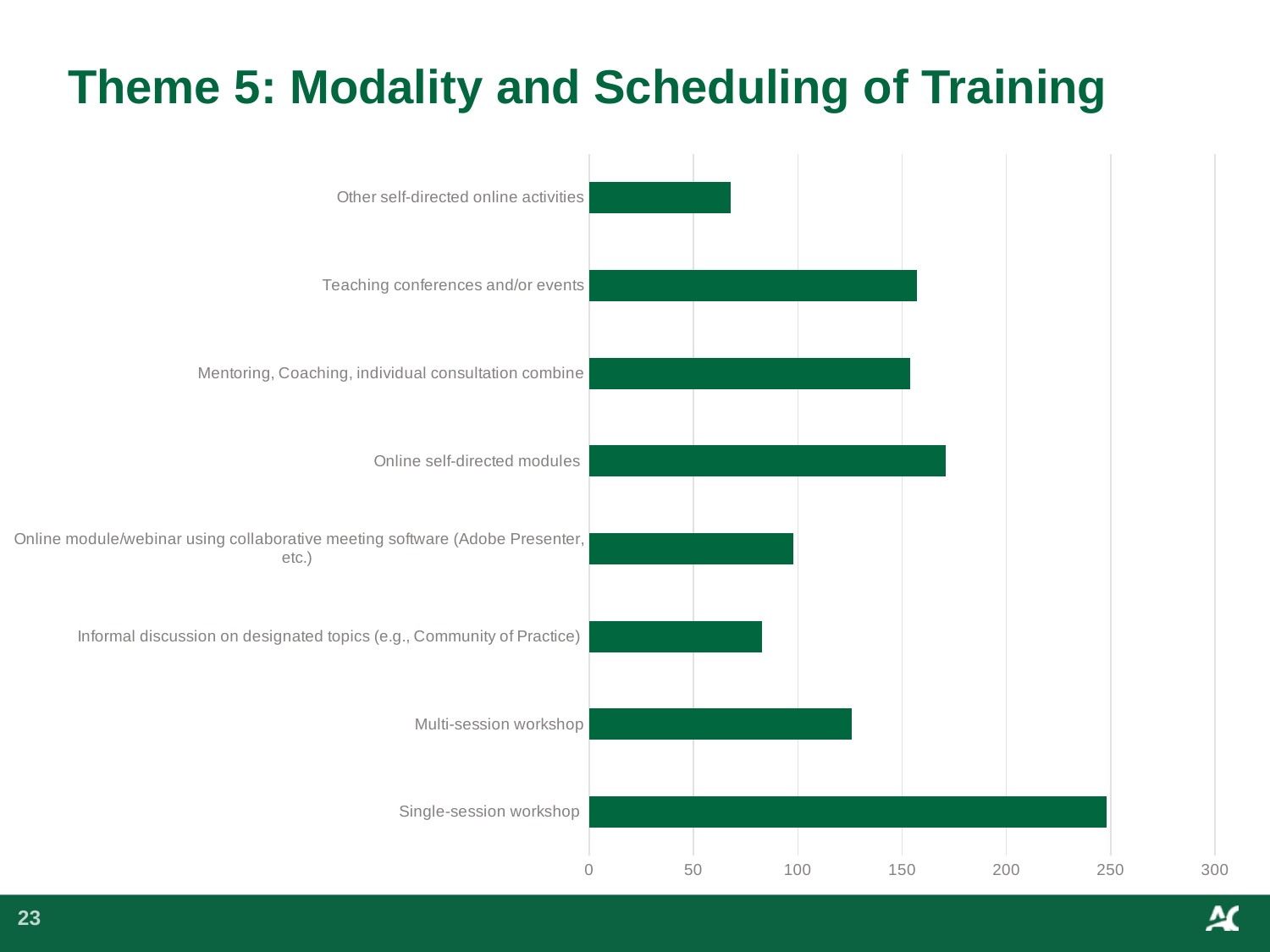
Is the value for Online self-directed modules greater or less than 150? greater Which is larger, the value for Online self-directed modules or the value for Informal discussion on designated topics (e.g., Community of Practice)? Online self-directed modules What kind of chart is shown on the slide? Bar chart Is the value for Other self-directed online activities greater or less than 100? less How many categories are plotted in the chart? 8 Which category has the lowest value? Other self-directed online activities What colour are the bars in the chart? Green Is the value for Multi-session workshop greater or less than 150? less Which is larger, the value for Single-session workshop or the value for Multi-session workshop? Single-session workshop Which category has the highest value? Single-session workshop What is the title of the slide containing the chart? Theme 5: Modality and Scheduling of Training